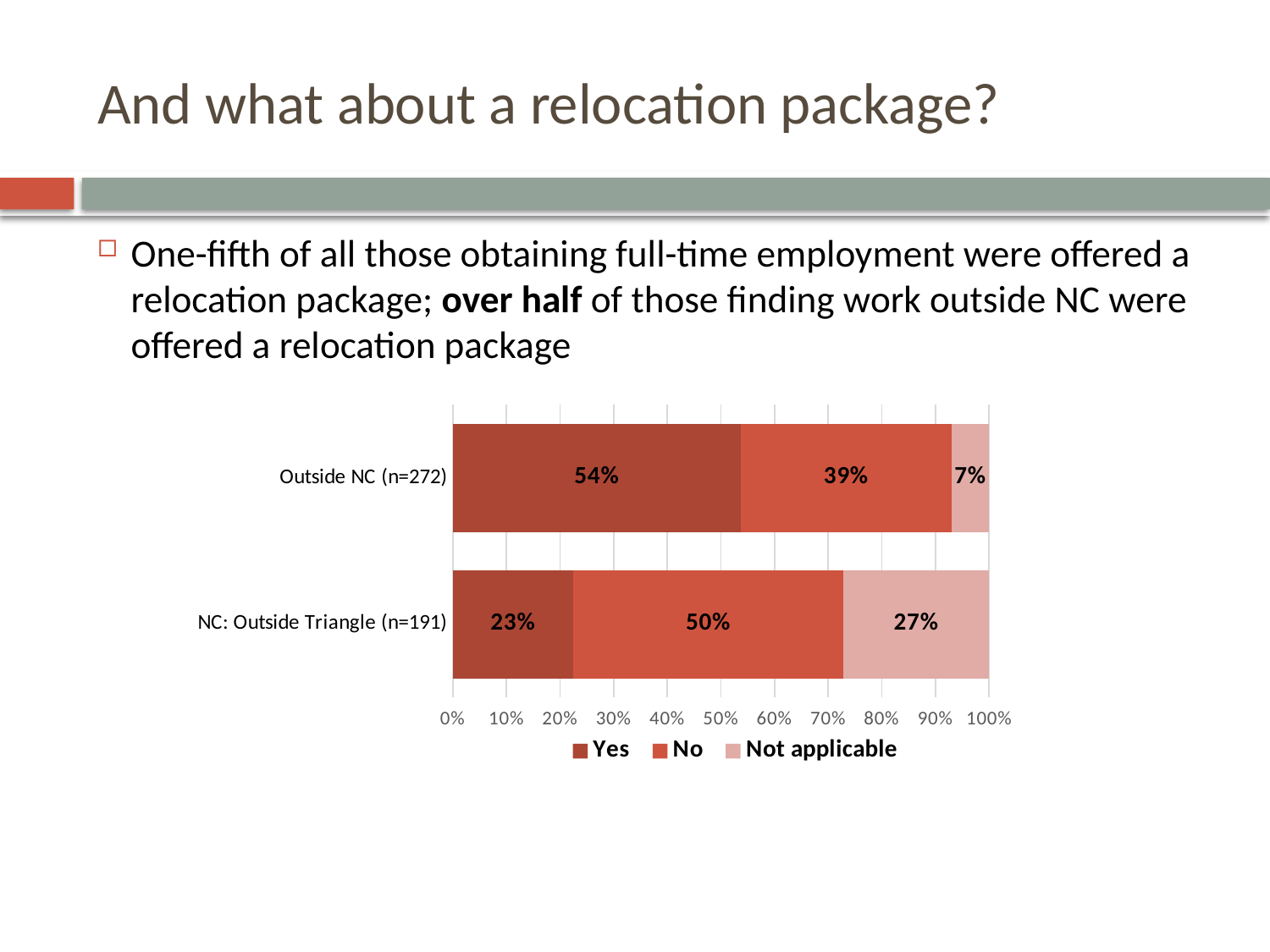
Which category has the lower Not applicable percentage? Outside NC (n=272) What percentage of the Outside NC (n=272) group answered Yes? 54% What is the Not applicable value for Outside NC (n=272)? 7% What is the Not applicable value for NC: Outside Triangle (n=191)? 27% What kind of chart is shown on the slide? Stacked bar chart What is the difference between the Yes percentages for Outside NC (n=272) and NC: Outside Triangle (n=191)? 31 percentage points How many categories are shown on the chart? 2 What are the three legend entries on the chart? Yes, No, Not applicable What percentage of the NC: Outside Triangle (n=191) group answered No? 50% Is the No percentage larger for Outside NC (n=272) or for NC: Outside Triangle (n=191)? NC: Outside Triangle (n=191) How many series does the legend list? 3 Which category has the higher Yes percentage? Outside NC (n=272)